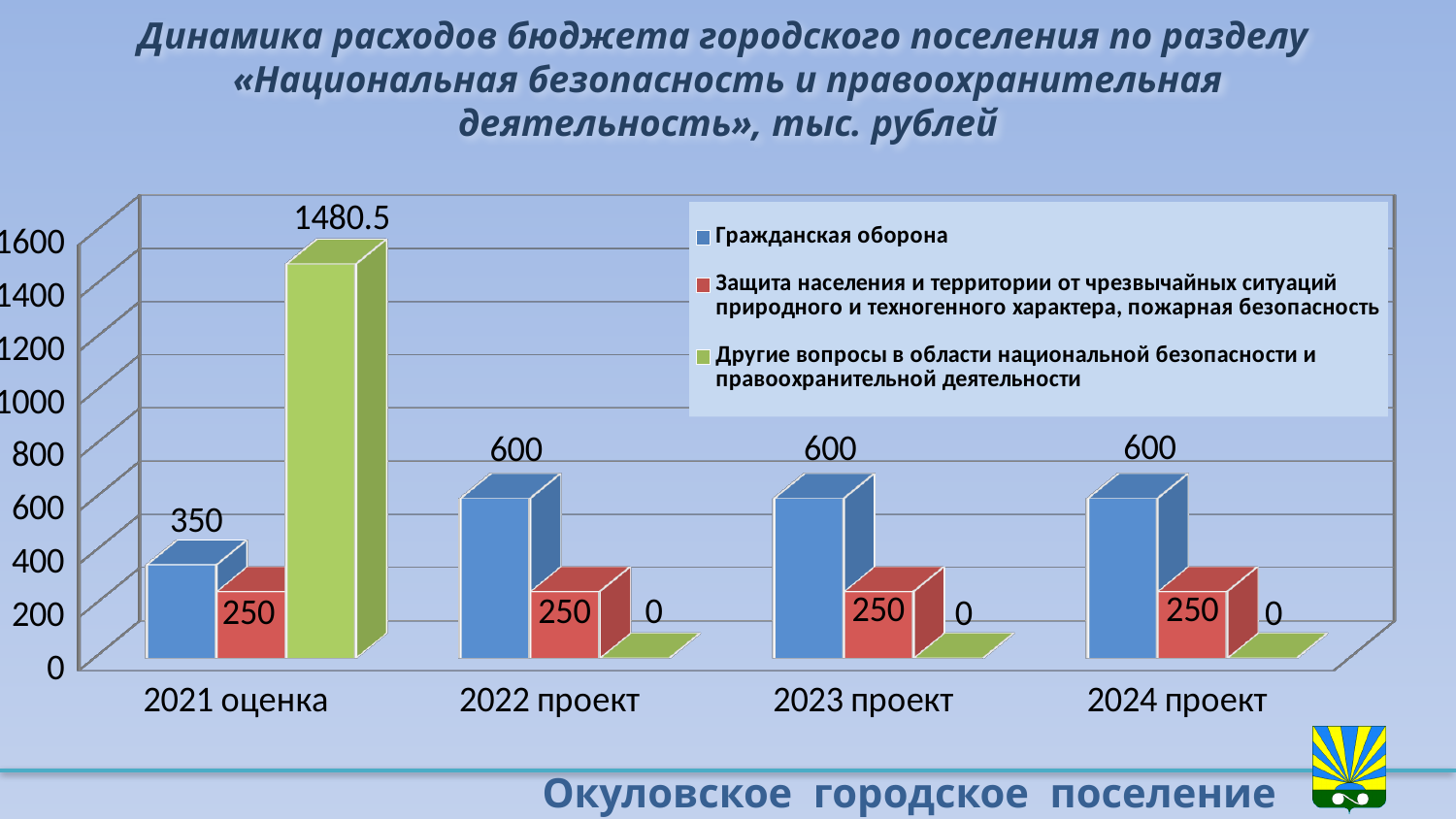
What is the value for Другие вопросы в области национальной безопасности и правоохранительной деятельности in 2022 проект? 0 Which is larger in 2021 оценка: Гражданская оборона or Другие вопросы в области национальной безопасности и правоохранительной деятельности? Другие вопросы в области национальной безопасности и правоохранительной деятельности What is the difference between the Гражданская оборона values for 2022 проект and 2021 оценка? 250 Which category has the highest value for Другие вопросы в области национальной безопасности и правоохранительной деятельности? 2021 оценка How many categories are shown on the x axis? 4 What is the value for Гражданская оборона in 2023 проект? 600 What is the value for Другие вопросы в области национальной безопасности и правоохранительной деятельности in 2021 оценка? 1480.5 What is the value for Защита населения и территории от чрезвычайных ситуаций природного и техногенного характера, пожарная безопасность in 2024 проект? 250 What is the value for Гражданская оборона in 2021 оценка? 350 How many series does the legend list? 3 What kind of chart is shown on the slide? bar chart Which category has the lowest value for Гражданская оборона? 2021 оценка